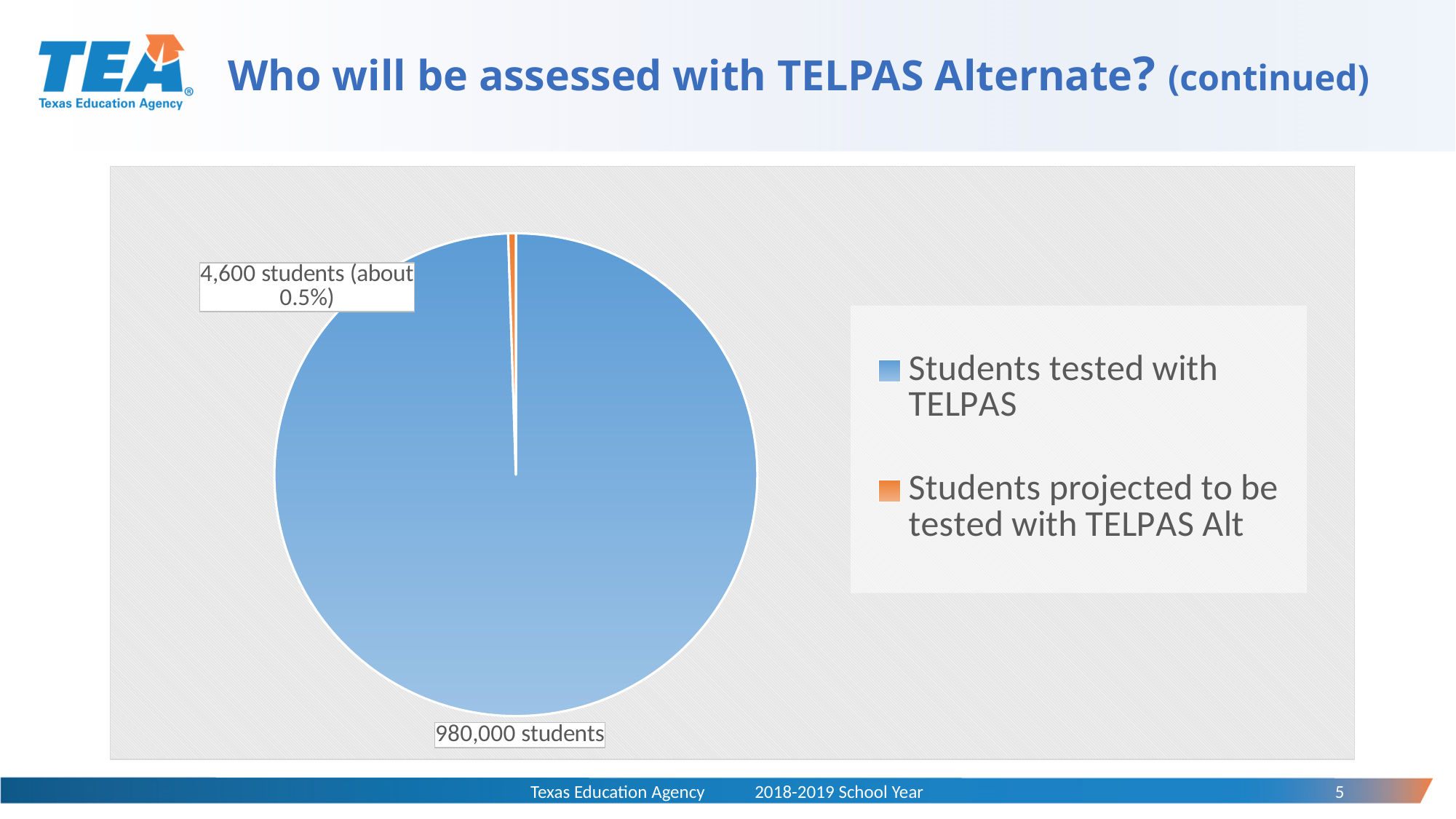
How many slices does the pie chart have? 2 What percentage does the data label give for the Students projected to be tested with TELPAS Alt slice? about 0.5% What value is labelled for the Students tested with TELPAS slice? 980,000 students Which is larger: the number of students tested with TELPAS or the number projected to be tested with TELPAS Alt? Students tested with TELPAS Which category has the smallest slice of the pie? Students projected to be tested with TELPAS Alt What kind of chart is shown on the slide? pie chart How many students are labelled as projected to be tested with TELPAS Alt? 4,600 students What is the difference between the number of students tested with TELPAS and the number projected to be tested with TELPAS Alt? 975,400 students Which category has the largest slice of the pie? Students tested with TELPAS How many entries does the legend list? 2 What is the title of the slide containing the pie chart? Who will be assessed with TELPAS Alternate? (continued) What colour is the slice for Students projected to be tested with TELPAS Alt? orange